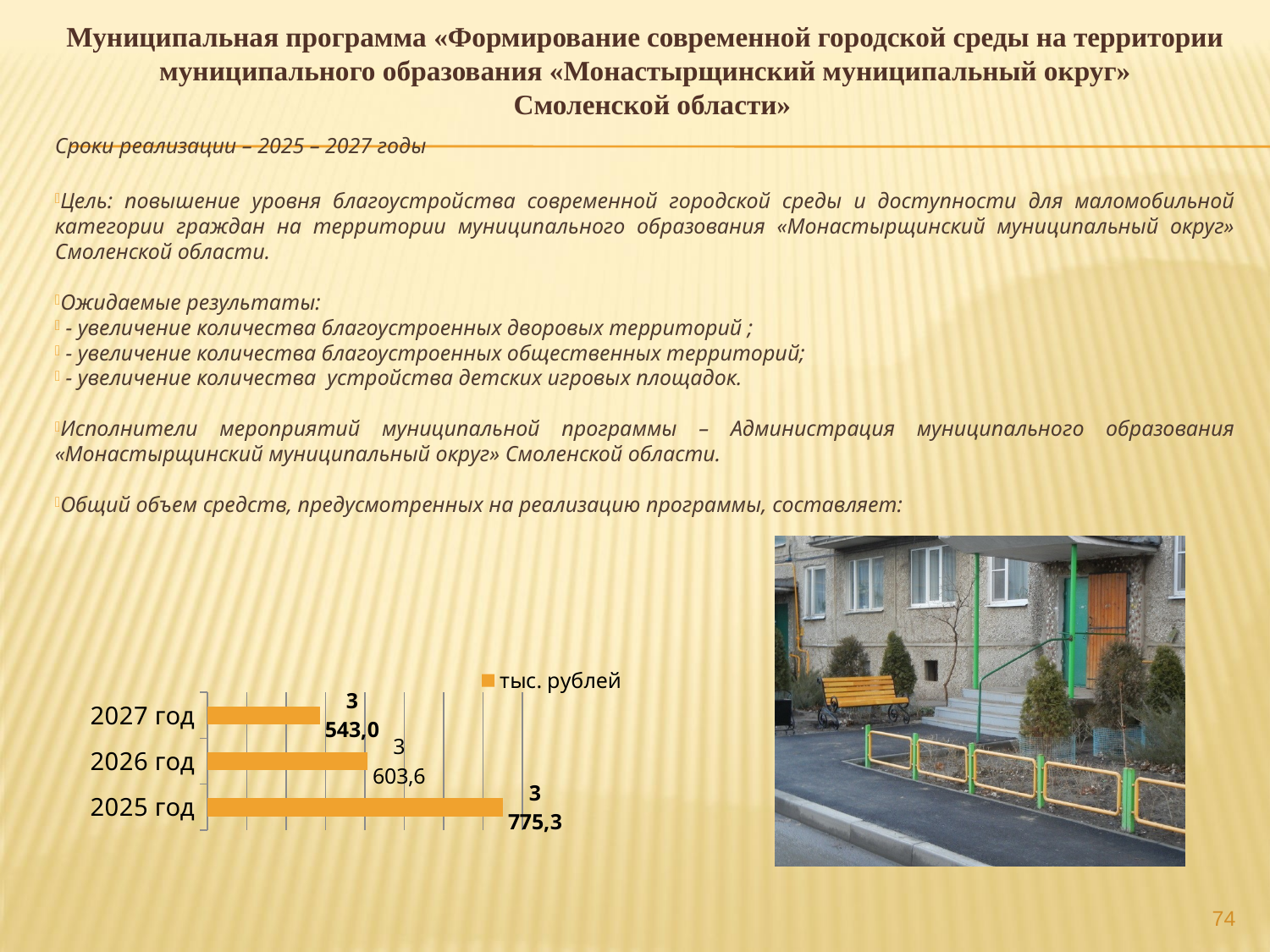
What is the difference between the values for 2025 год and 2026 год? 171,7 Do the values rise or fall from 2025 год to 2027 год? fall Which year has the lowest value in the chart? 2027 год What is the value for 2025 год in the chart? 3 775,3 Which is larger, the value for 2026 год or the value for 2027 год? 2026 год What is the difference between the values for 2025 год and 2027 год? 232,3 What is the value for 2027 год in the chart? 3 543,0 What is the value for 2026 год in the chart? 3 603,6 How many years (categories) are shown in the chart? 3 How many series does the chart legend list? 1 What kind of chart is shown on the slide? bar chart Which year has the highest value in the chart? 2025 год